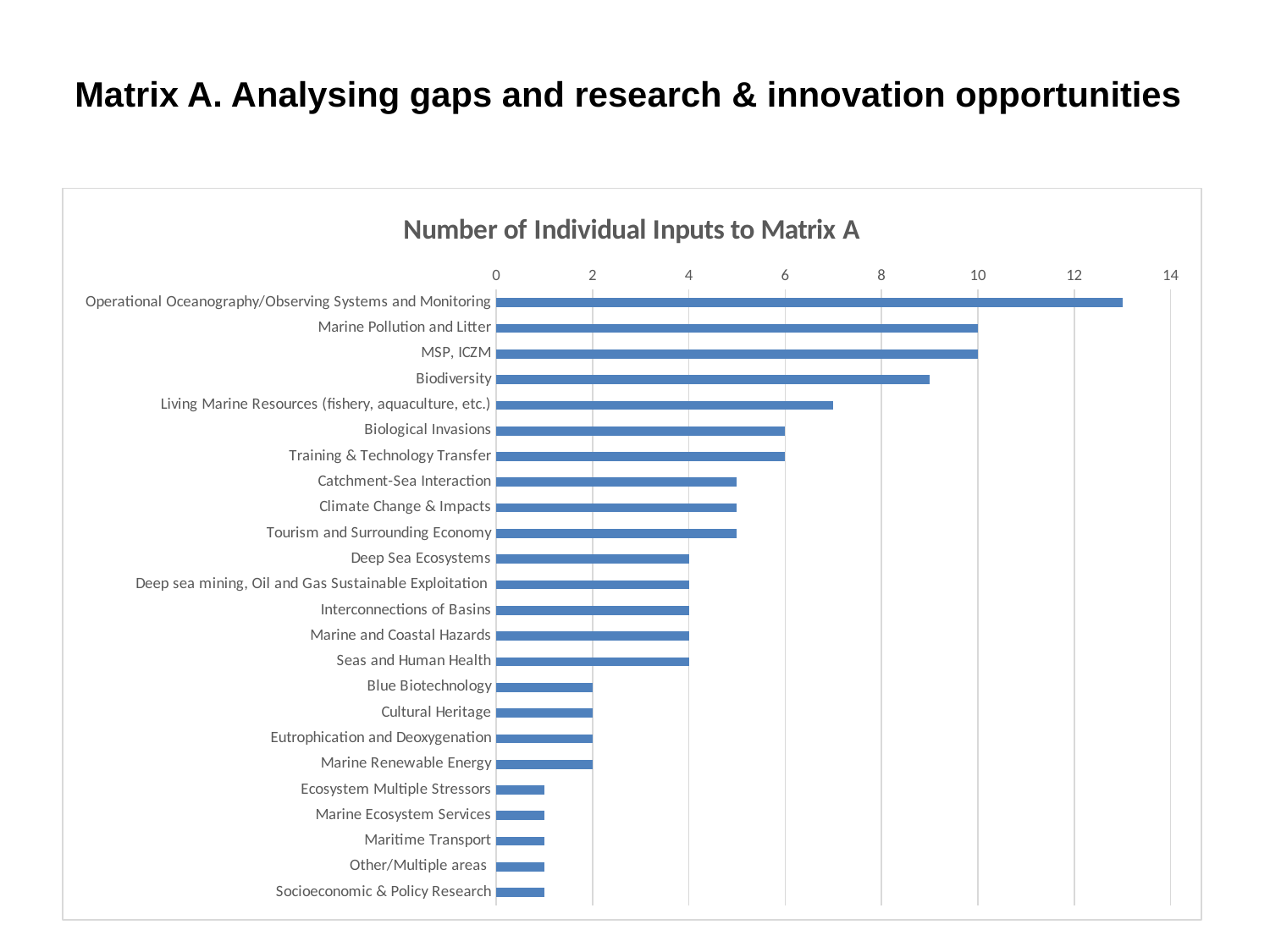
Which has a larger value, Biodiversity or Living Marine Resources (fishery, aquaculture, etc.)? Biodiversity Is the value for Socioeconomic & Policy Research greater or less than 2? less What is the value for Marine Pollution and Litter? 10 What type of chart is shown on the slide? bar chart What is the value for Biological Invasions? 6 What is the value for Blue Biotechnology? 2 Which category has the highest number of individual inputs? Operational Oceanography/Observing Systems and Monitoring What is the difference between the values for Marine Pollution and Litter and Biological Invasions? 4 What is the value for Seas and Human Health? 4 What is the title of the chart? Number of Individual Inputs to Matrix A How many categories are plotted in the chart? 24 Is the value for Operational Oceanography/Observing Systems and Monitoring greater or less than 12? greater